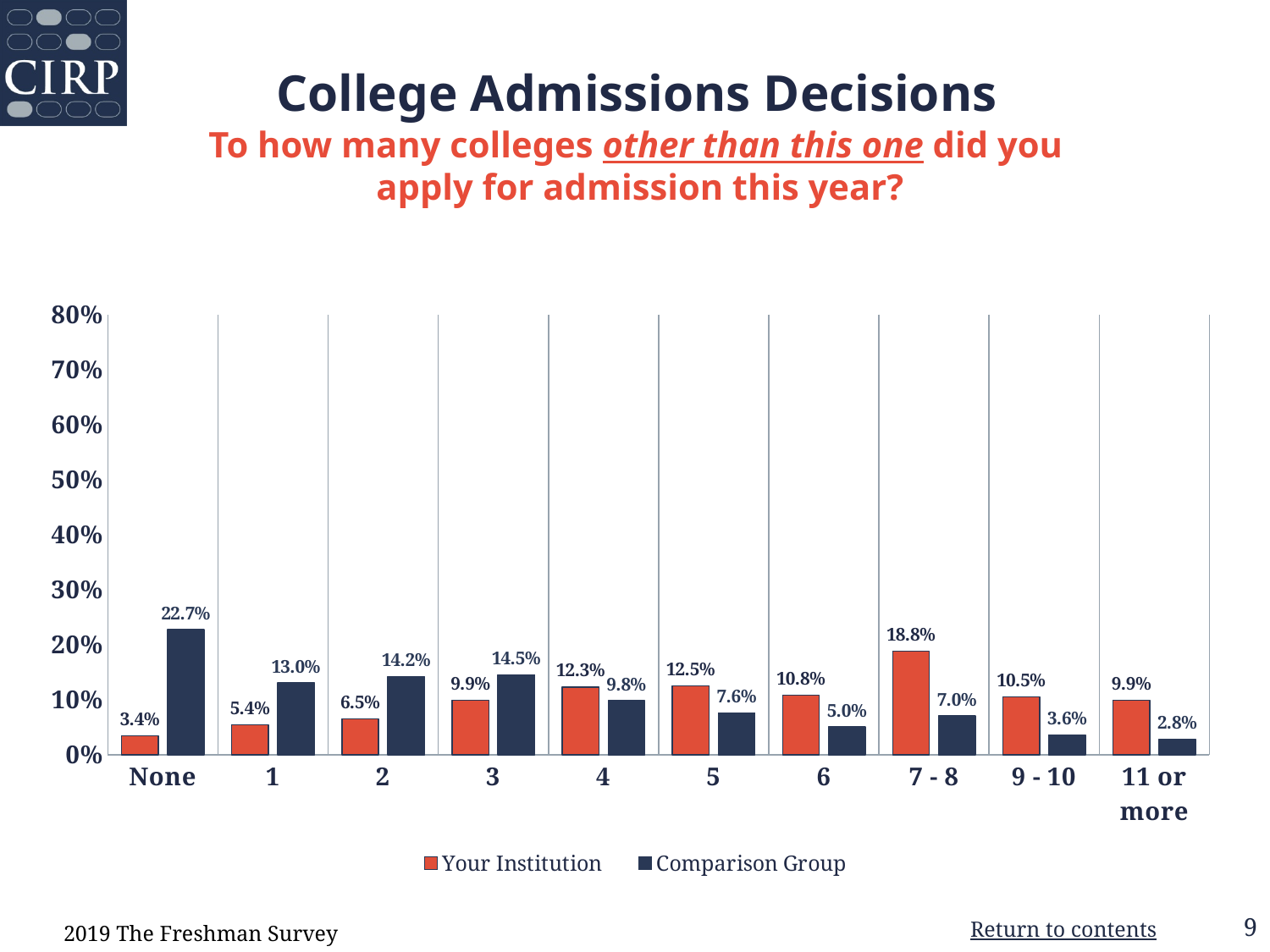
What is the difference between Comparison Group and Your Institution in the None category? 19.3% Is the value for Comparison Group in the None category greater or less than 20%? greater What kind of chart is shown on the slide? bar chart Which category has the highest value for Comparison Group? None What is the value for Comparison Group in the 7 - 8 category? 7.0% Which series is shown in orange? Your Institution How many series does the legend list? 2 Which is larger in the 7 - 8 category, Your Institution or Comparison Group? Your Institution What is the value for Your Institution in the None category? 3.4% How many categories are shown on the x axis? 10 Which category has the lowest value for Your Institution? None What is the value for Your Institution in the 11 or more category? 9.9%